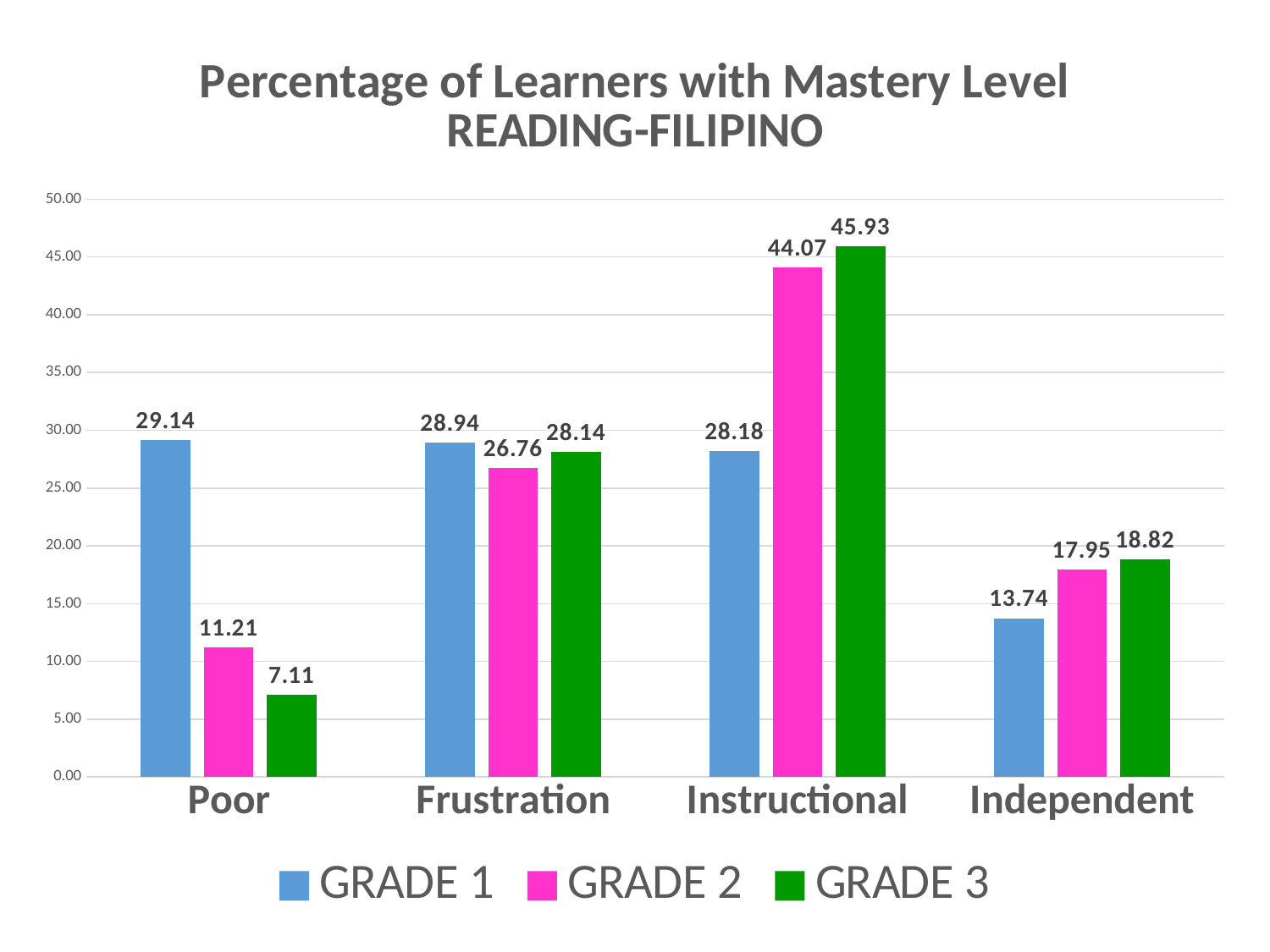
What is the value for GRADE 2 in the Independent category? 17.95 What is the value for GRADE 3 in the Instructional category? 45.93 How many series does the legend list? 3 What is the difference between GRADE 3 and GRADE 2 in the Instructional category? 1.86 Which category has the highest value for GRADE 2? Instructional Which category has the lowest value for GRADE 3? Poor What kind of chart is shown on the slide? Bar chart How many categories are shown on the x axis? 4 What is the value for GRADE 1 in the Poor category? 29.14 Which is larger in the Frustration category, GRADE 1 or GRADE 2? GRADE 1 What is the difference between GRADE 1 and GRADE 3 in the Poor category? 22.03 Is the value for GRADE 2 in the Instructional category greater or less than 40.00? greater